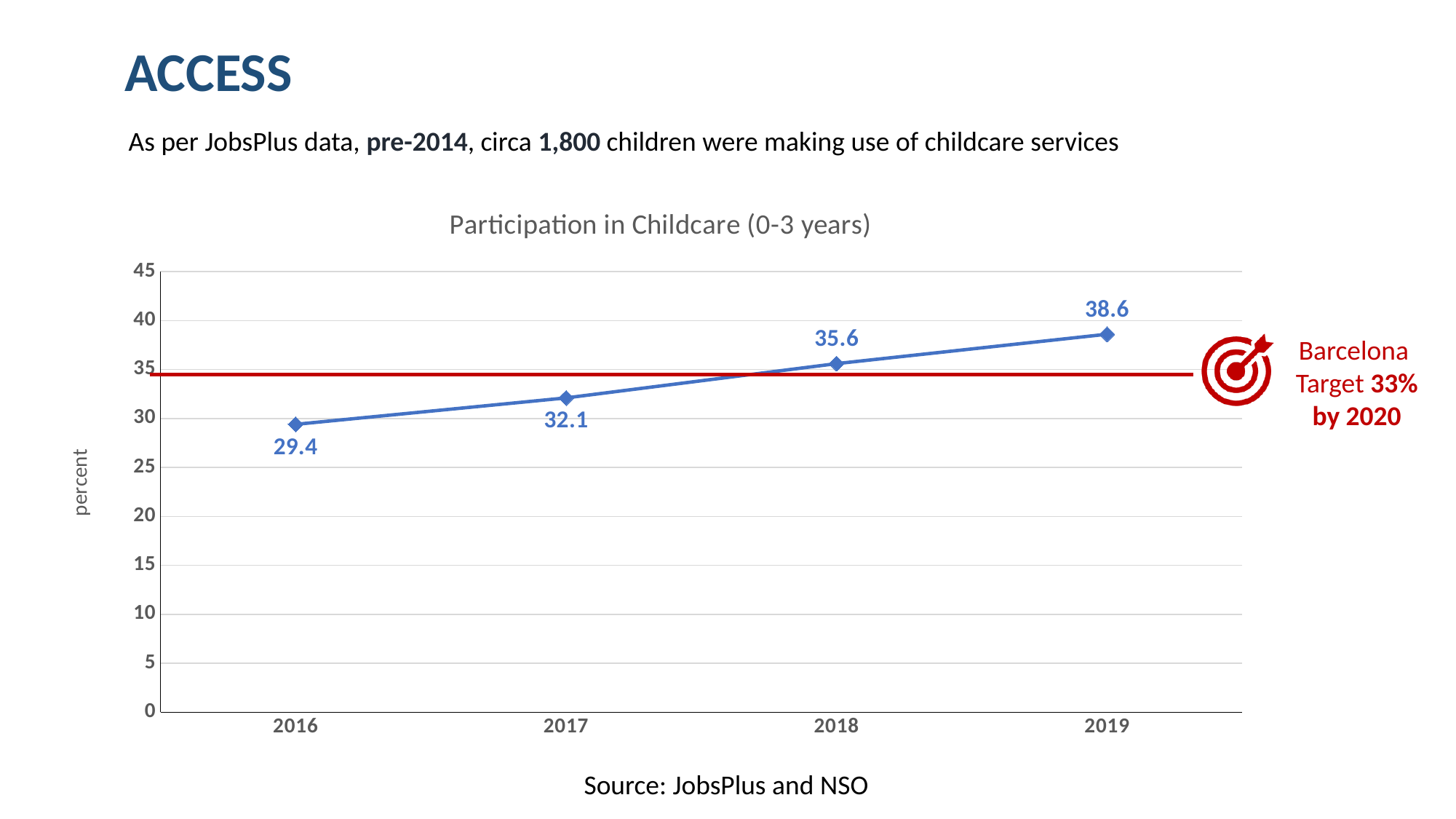
What is the participation in childcare value for 2016? 29.4 Which year has the lowest participation in childcare? 2016 Which year has the highest participation in childcare? 2019 What is the difference between the 2019 and 2016 participation values? 9.2 Is the participation value for 2017 greater or less than 35? less What kind of chart is shown on the slide? line chart What is the participation in childcare value for 2018? 35.6 How many years are plotted on the chart? 4 What is the difference between the 2018 and 2017 participation values? 3.5 Do the participation values rise or fall from 2016 to 2019? rise What is the participation in childcare value for 2019? 38.6 Which is larger, the participation value for 2017 or for 2018? 2018